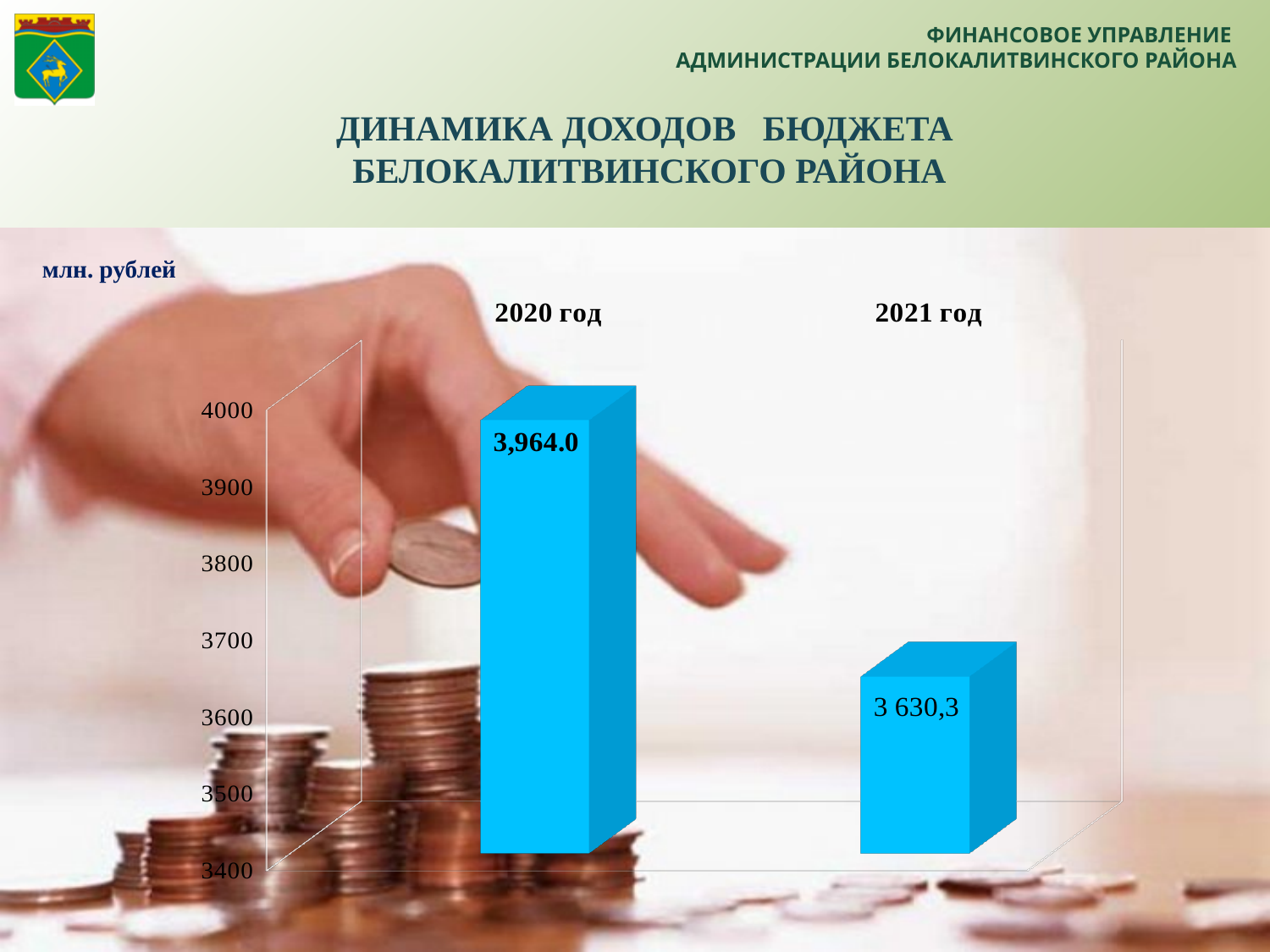
Which year has the highest value? 2020 год Do the values rise or fall from 2020 год to 2021 год? fall Is the value for 2021 год greater or less than 3700? less What is the value for 2021 год? 3 630,3 In what units are the chart values given? млн. рублей What is the difference between the values for 2020 год and 2021 год? 333.7 Which is larger, the value for 2020 год or for 2021 год? 2020 год What kind of chart is shown on the slide? bar chart What is the value for 2020 год? 3,964.0 Is the value for 2020 год greater or less than 3900? greater Which year has the lowest value? 2021 год How many bars are shown in the chart? 2